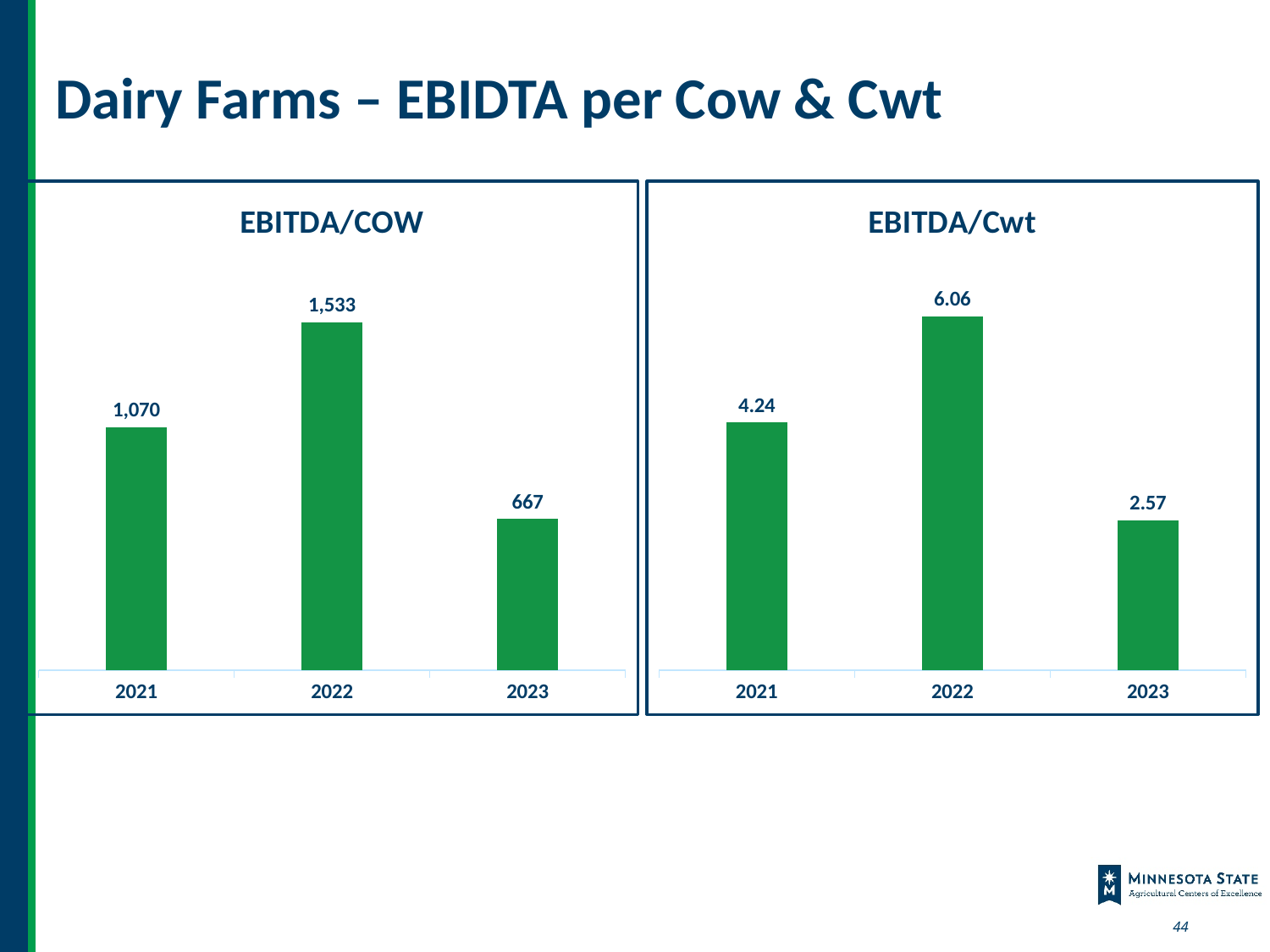
In the EBITDA/Cwt chart, what is the difference between the 2022 and 2023 values? 3.49 In the EBITDA/COW chart, what is the value for 2023? 667 What kind of chart is the EBITDA/COW chart? Bar chart In the EBITDA/COW chart, which year has the highest value? 2022 In the EBITDA/Cwt chart, which year has the lowest value? 2023 In the EBITDA/Cwt chart, does the value rise or fall from 2022 to 2023? Fall In the EBITDA/COW chart, what is the value for 2022? 1,533 In the EBITDA/Cwt chart, what is the value for 2021? 4.24 How many years are shown in the EBITDA/Cwt chart? 3 In the EBITDA/Cwt chart, what is the value for 2023? 2.57 In the EBITDA/COW chart, which is larger, the value for 2021 or the value for 2023? 2021 In the EBITDA/COW chart, what is the difference between the 2022 and 2021 values? 463